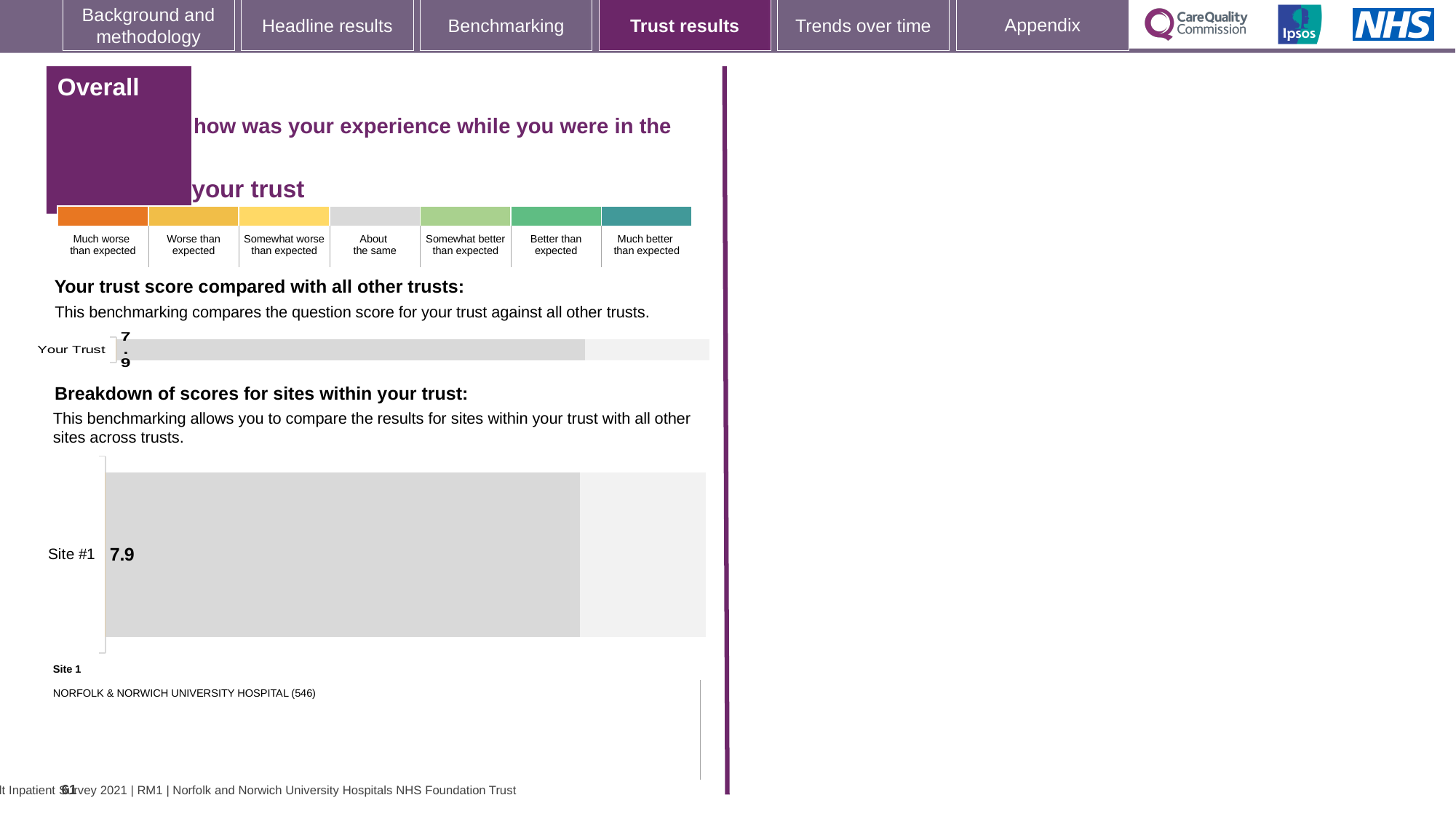
In the 'Your trust score compared with all other trusts' chart, what is the score for Your Trust? 7.9 How many rating categories does the colour key above the charts list, from 'Much worse than expected' to 'Much better than expected'? 7 What kind of chart is the 'Breakdown of scores for sites within your trust' chart? bar chart Which site is labelled Site #1 in the 'Breakdown of scores for sites within your trust' chart? NORFOLK & NORWICH UNIVERSITY HOSPITAL (546) What is the difference between the Site #1 score and the Your Trust score on this slide? 0.0 How many bars are plotted in the 'Your trust score compared with all other trusts' chart? 1 What kind of chart is the 'Your trust score compared with all other trusts' chart? bar chart How many sites are plotted in the 'Breakdown of scores for sites within your trust' chart? 1 In the 'Breakdown of scores for sites within your trust' chart, what is the score for Site #1? 7.9 Is the score for Site #1 in the 'Breakdown of scores for sites within your trust' chart greater or less than the score for Your Trust in the trust chart, or are they equal? equal